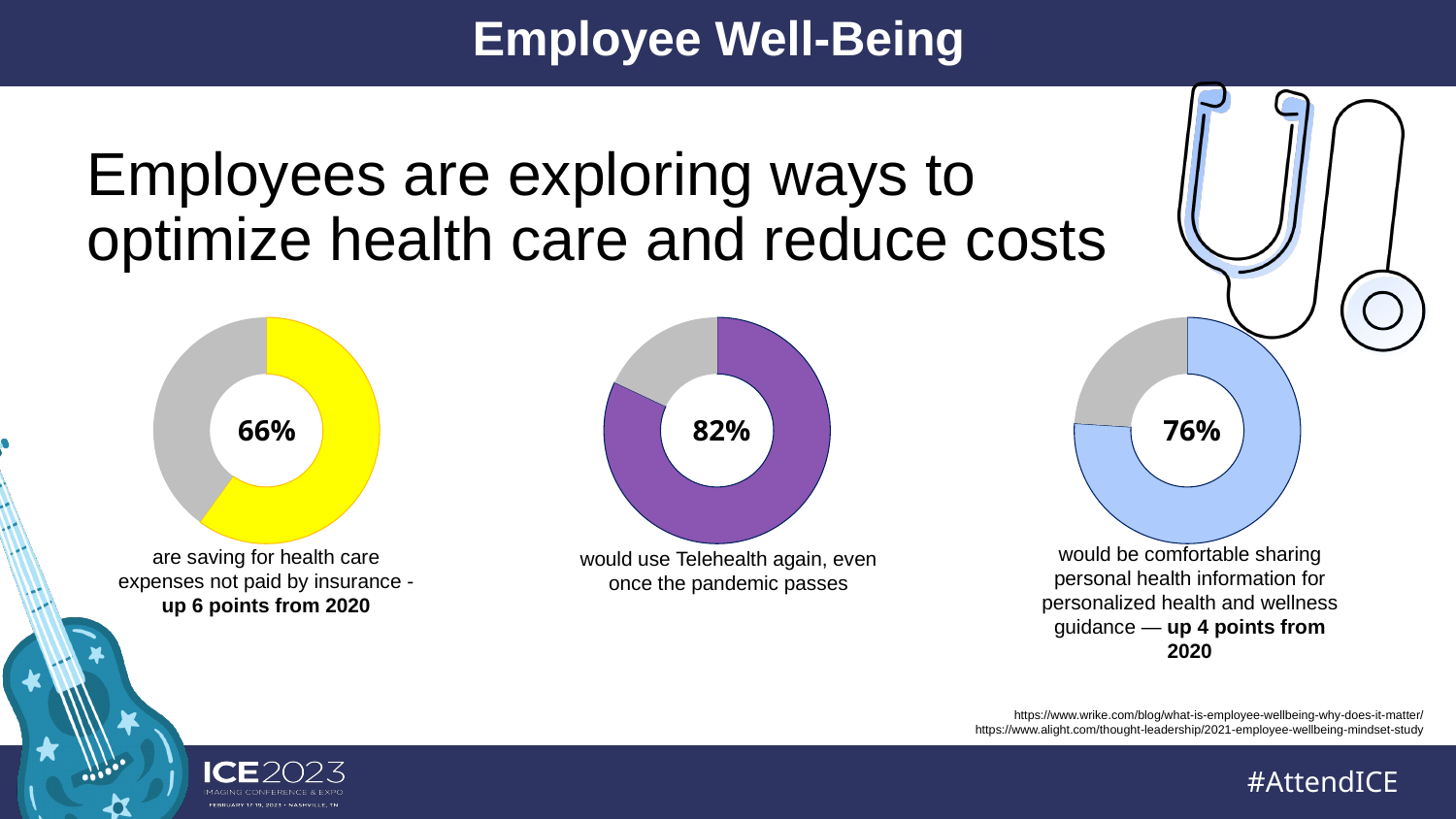
What is the difference between the Telehealth percentage (middle chart) and the saving for health care expenses percentage (left chart)? 16 percentage points What kind of charts are used on this slide to show the three percentages? Doughnut (pie) charts What percentage is shown in the right-hand doughnut chart about sharing personal health information? 76% How many doughnut charts are on the slide? 3 What percentage is shown in the centre of the left-hand doughnut chart (saving for health care expenses)? 66% What colour is the highlighted segment of the middle doughnut chart? Purple Which is larger: the percentage in the left chart (saving for health care expenses) or the percentage in the right chart (sharing personal health information)? The right chart, 76% Which of the three doughnut charts shows the highest percentage? The middle chart (Telehealth), 82% What is the difference between the middle chart's 82% and the right chart's 76%? 6 percentage points Which of the three doughnut charts shows the lowest percentage? The left chart (saving for health care expenses), 66% What percentage is shown in the middle doughnut chart about using Telehealth again? 82%